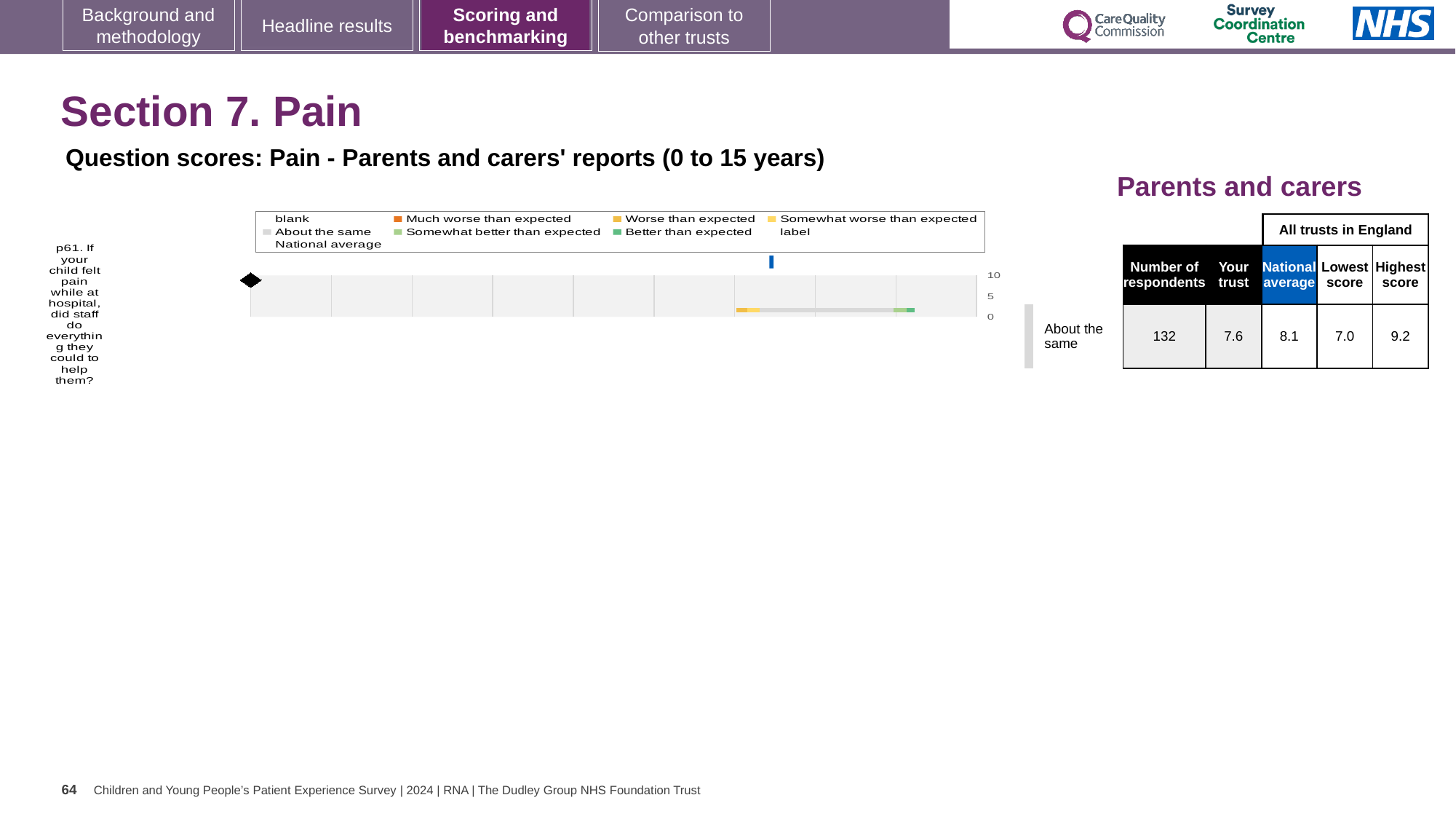
What type of chart is used to show the p61 question score? bar chart What is the national average score for question p61? 8.1 What is the difference between the highest and lowest scores for question p61? 2.2 Which benchmarking category is the trust's result for question p61 placed in? About the same How many survey questions are plotted in the chart? 1 How many respondents answered question p61? 132 Which is larger for question p61, the 'Your trust' score or the national average? National average What is the 'Your trust' score for question p61? 7.6 What is the highest value shown on the chart's score axis? 10 What is the highest score among all trusts in England for question p61? 9.2 Which legend entry is shown in orange? Much worse than expected What is the lowest score among all trusts in England for question p61? 7.0